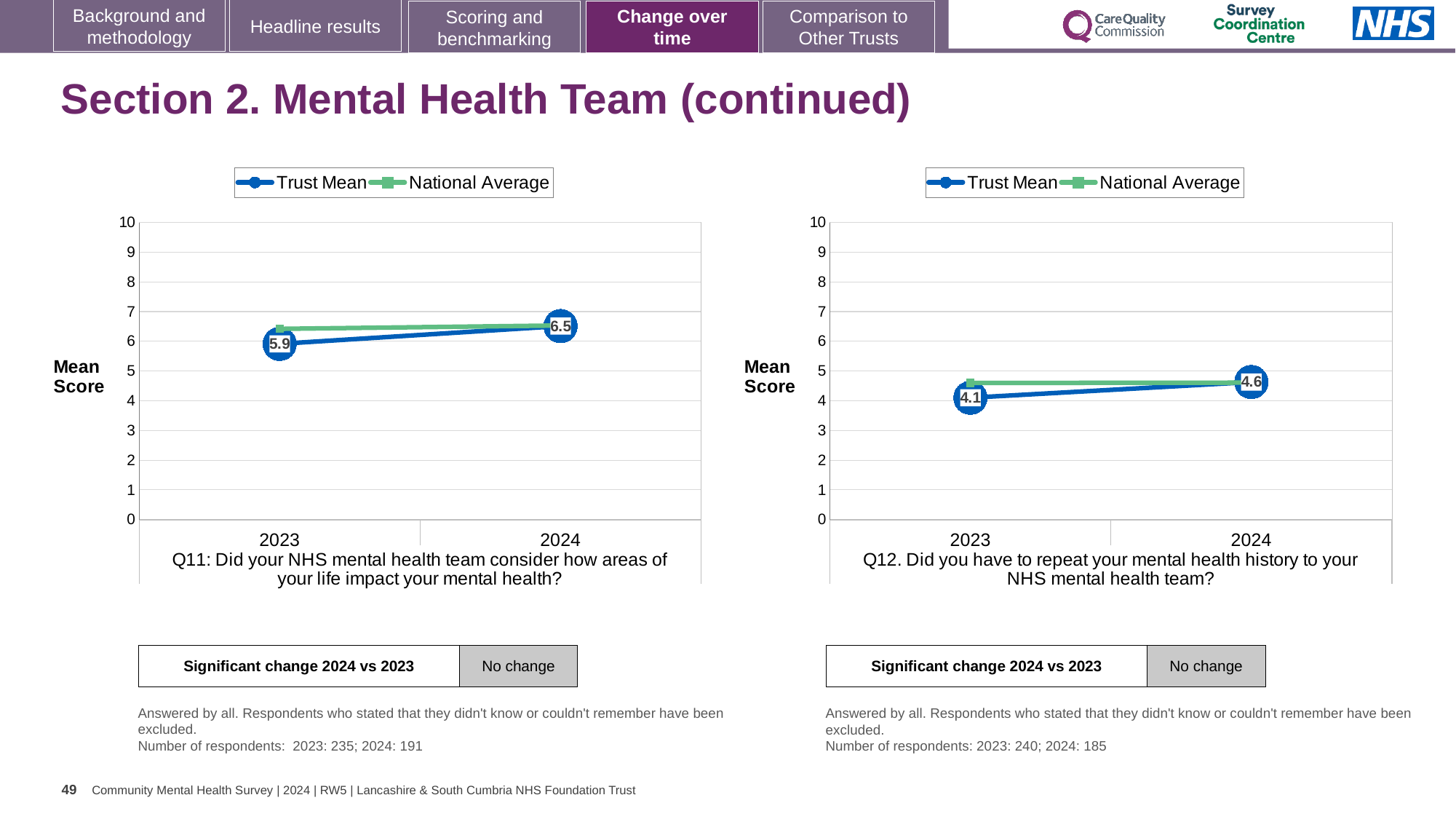
In the Q11 chart (left), does the Trust Mean rise or fall from 2023 to 2024? rise In the Q11 chart (left), is the National Average for 2023 greater or less than 6? greater How many series does the legend of the Q12 chart (right) list? 2 In the Q11 chart (left), which is larger in 2023, the Trust Mean or the National Average? National Average In the Q11 chart (left), by how much did the Trust Mean change from 2023 to 2024? 0.6 In the Q12 chart (right), is the Trust Mean for 2023 greater or less than 5? less In the Q11 chart (left), what is the Trust Mean for 2024? 6.5 What kind of chart is the Q11 chart (left)? line chart In the Q12 chart (right), what is the Trust Mean for 2024? 4.6 In the Q11 chart (left), what is the Trust Mean for 2023? 5.9 In the Q12 chart (right), what is the Trust Mean for 2023? 4.1 In the Q12 chart (right), what is the difference between the Trust Mean in 2024 and in 2023? 0.5